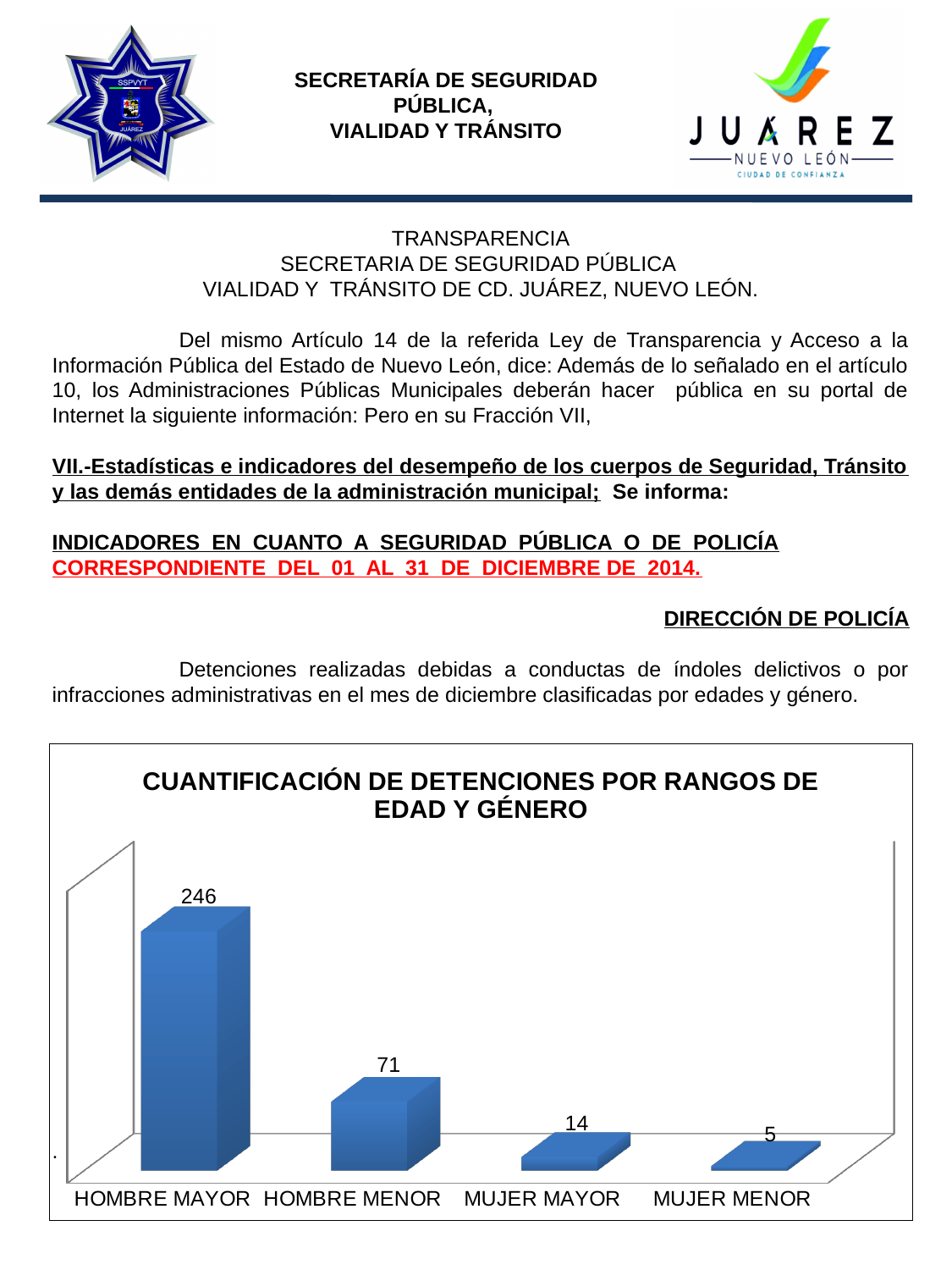
What kind of chart is shown on the slide? Bar chart What is the difference between the values for MUJER MAYOR and MUJER MENOR? 9 How many categories are shown in the chart? 4 Which is larger, the value for HOMBRE MENOR or the value for MUJER MAYOR? HOMBRE MENOR What is the title of the chart? CUANTIFICACIÓN DE DETENCIONES POR RANGOS DE EDAD Y GÉNERO Which category has the lowest value? MUJER MENOR What is the value for HOMBRE MENOR? 71 What is the value for MUJER MENOR? 5 Which category has the highest value? HOMBRE MAYOR What is the value for HOMBRE MAYOR? 246 What is the difference between the values for HOMBRE MAYOR and HOMBRE MENOR? 175 What is the value for MUJER MAYOR? 14